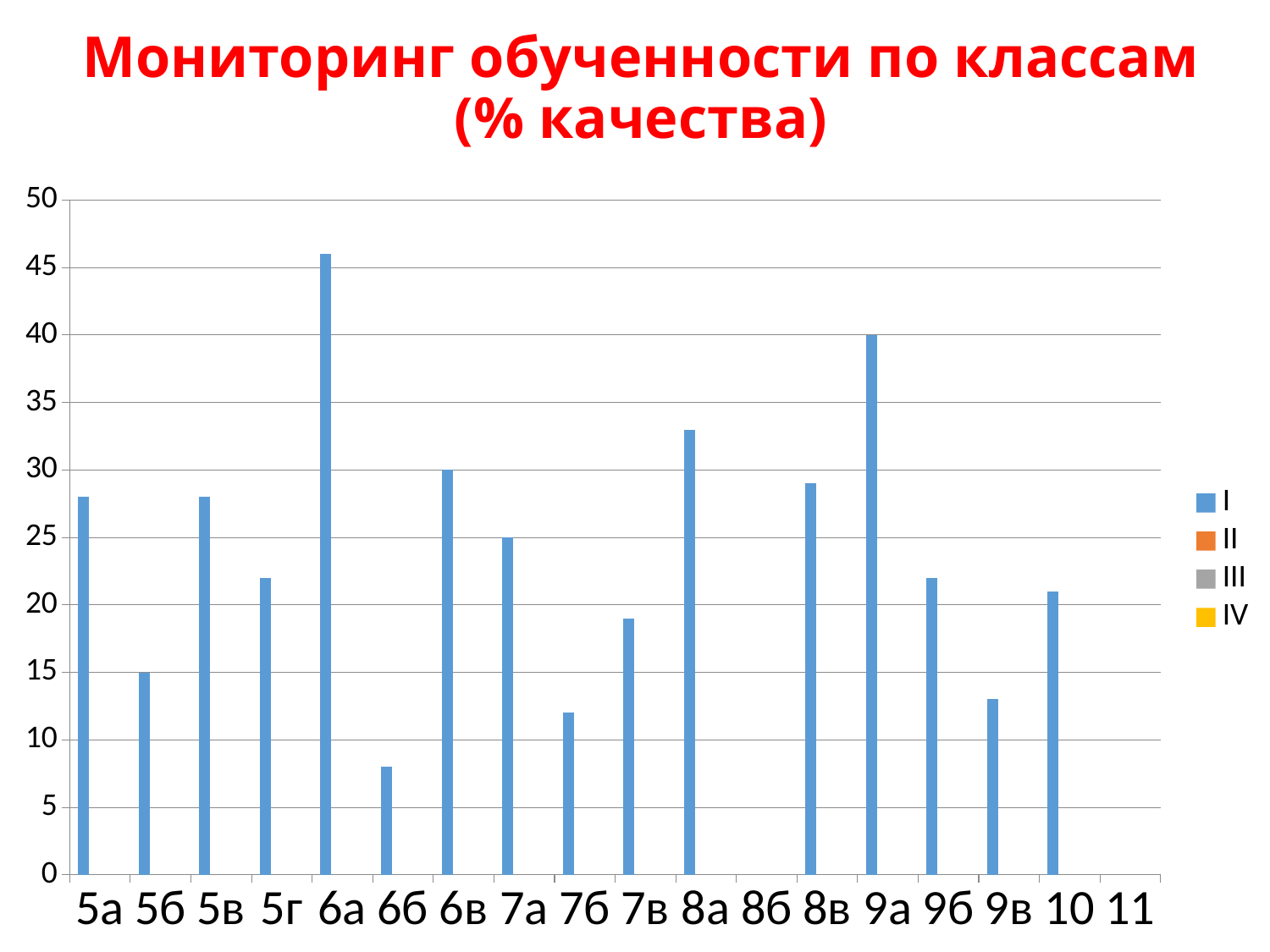
What is the value for class 6в? 30 How many series does the legend list? 4 Is the value for 6а greater or less than 45? greater What kind of chart is shown on the slide? bar chart Which is larger, the value for 8а or the value for 8в? 8а What is the value for class 9а? 40 Is the value for 6б greater or less than 10? less What is the value for class 5б? 15 What is the difference between the values for 9а and 5б? 25 How many class categories are shown on the x axis? 18 Which class has the highest value? 6а What is the title of the chart? Мониторинг обученности по классам (% качества)